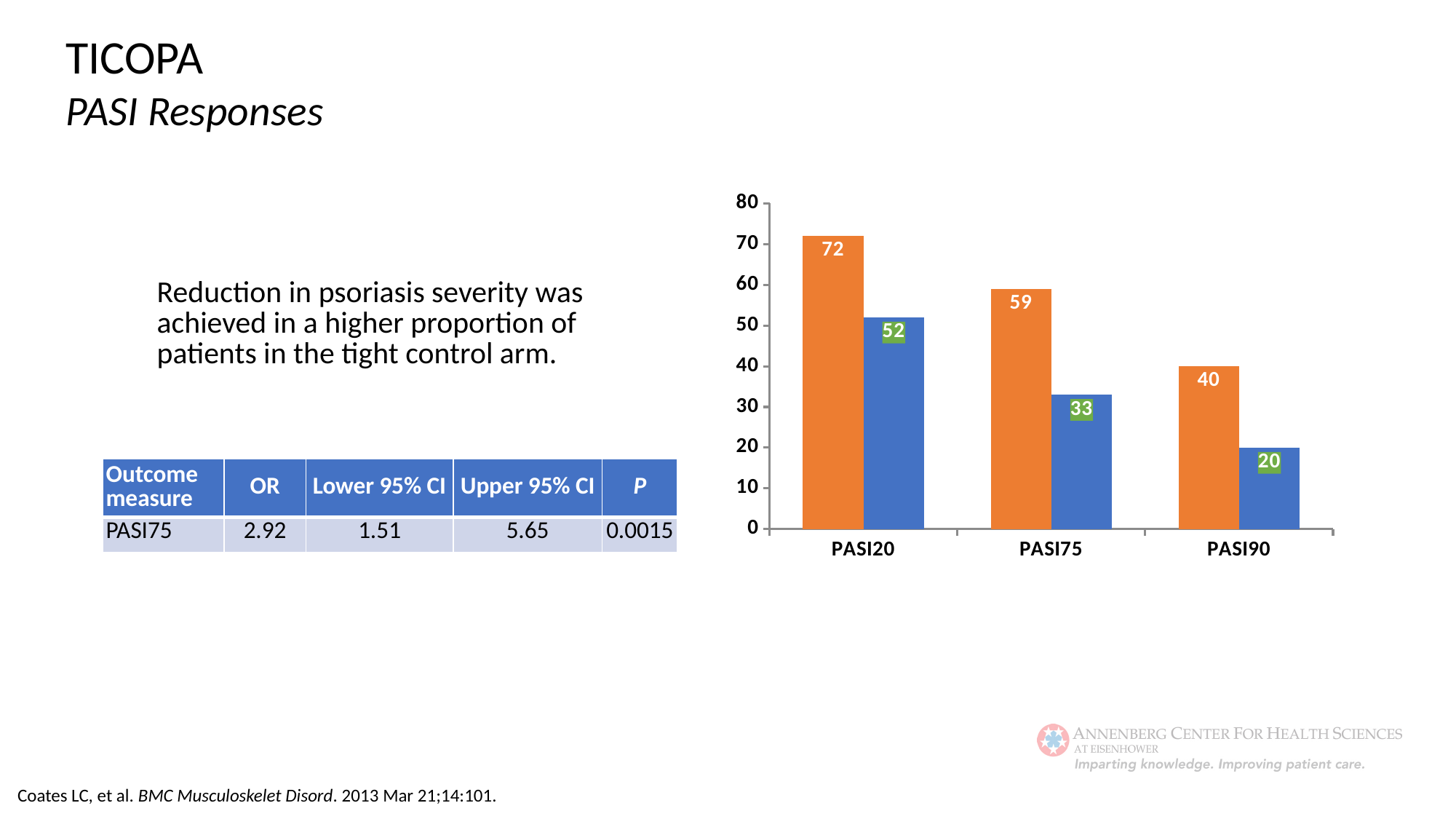
Which category has the highest orange bar? PASI20 Which is larger for PASI20, the orange bar or the blue bar? the orange bar What is the value of the orange bar for PASI20? 72 What is the value of the orange bar for PASI90? 40 What is the value of the blue bar for PASI75? 33 How many categories are shown on the x axis of the chart? 3 What is the difference between the orange bar for PASI20 and the orange bar for PASI90? 32 Do the orange bars rise or fall from PASI20 to PASI90? fall What is the value of the blue bar for PASI90? 20 What is the difference between the orange and blue bars for PASI75? 26 Which category has the lowest blue bar? PASI90 What kind of chart is shown on the slide? bar chart